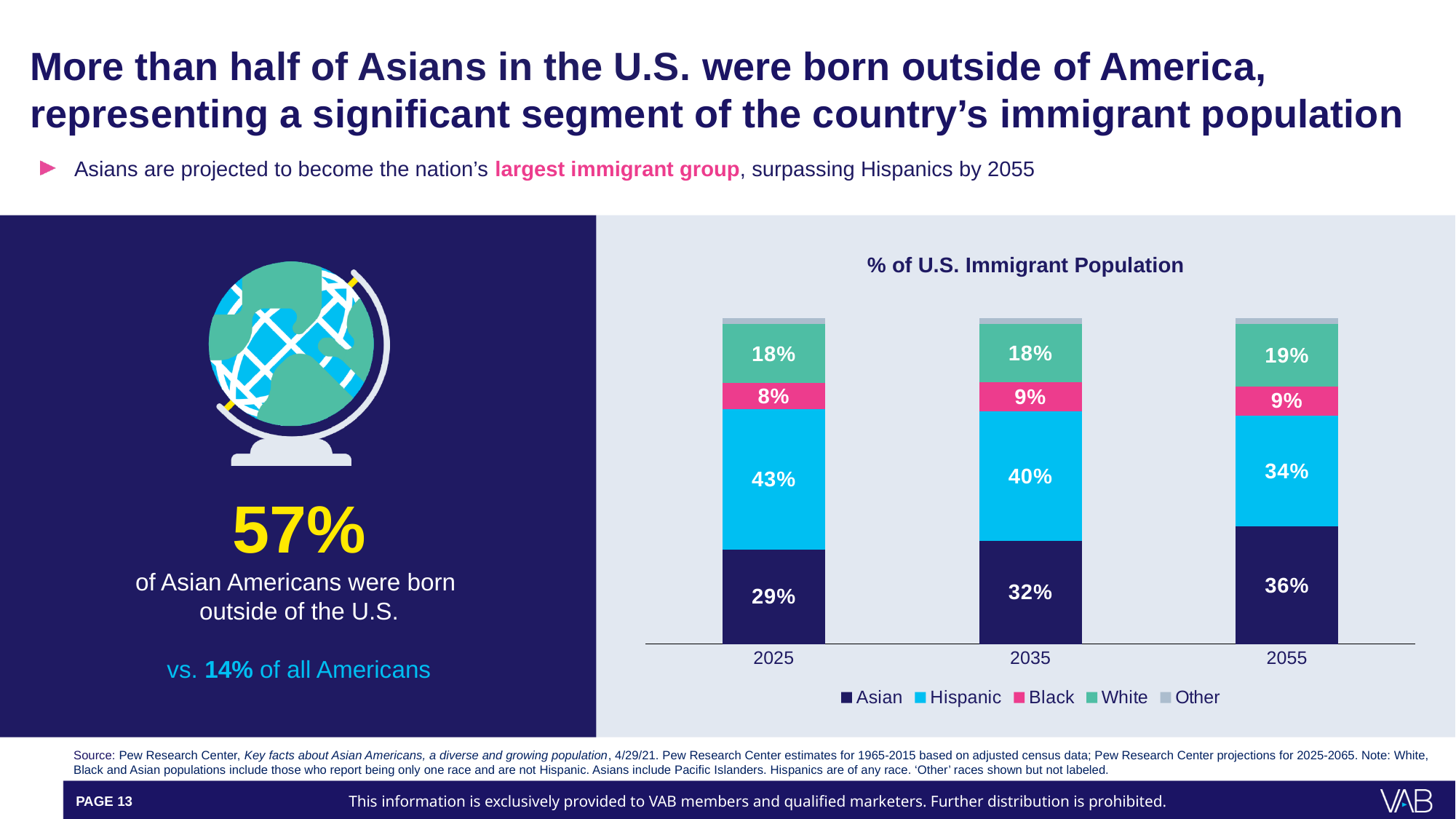
How many series does the chart legend list? 5 What is the Asian share of the U.S. immigrant population projected for 2055? 36% What is the White share of the U.S. immigrant population shown for 2035? 18% What kind of chart is used to show the % of U.S. Immigrant Population? Stacked bar chart In which year is the Hispanic share of the U.S. immigrant population lowest? 2055 By how many percentage points does the Hispanic share exceed the Asian share in 2025? 14 percentage points What is the Hispanic share of the U.S. immigrant population shown for 2025? 43% Which is larger in 2035, the Asian share or the Hispanic share of the immigrant population? Hispanic How many years are shown on the x axis of the chart? 3 In which year is the Asian share of the U.S. immigrant population highest? 2055 What is the Black share of the U.S. immigrant population shown for 2025? 8% Does the Asian share of the U.S. immigrant population rise or fall from 2025 to 2055? Rise